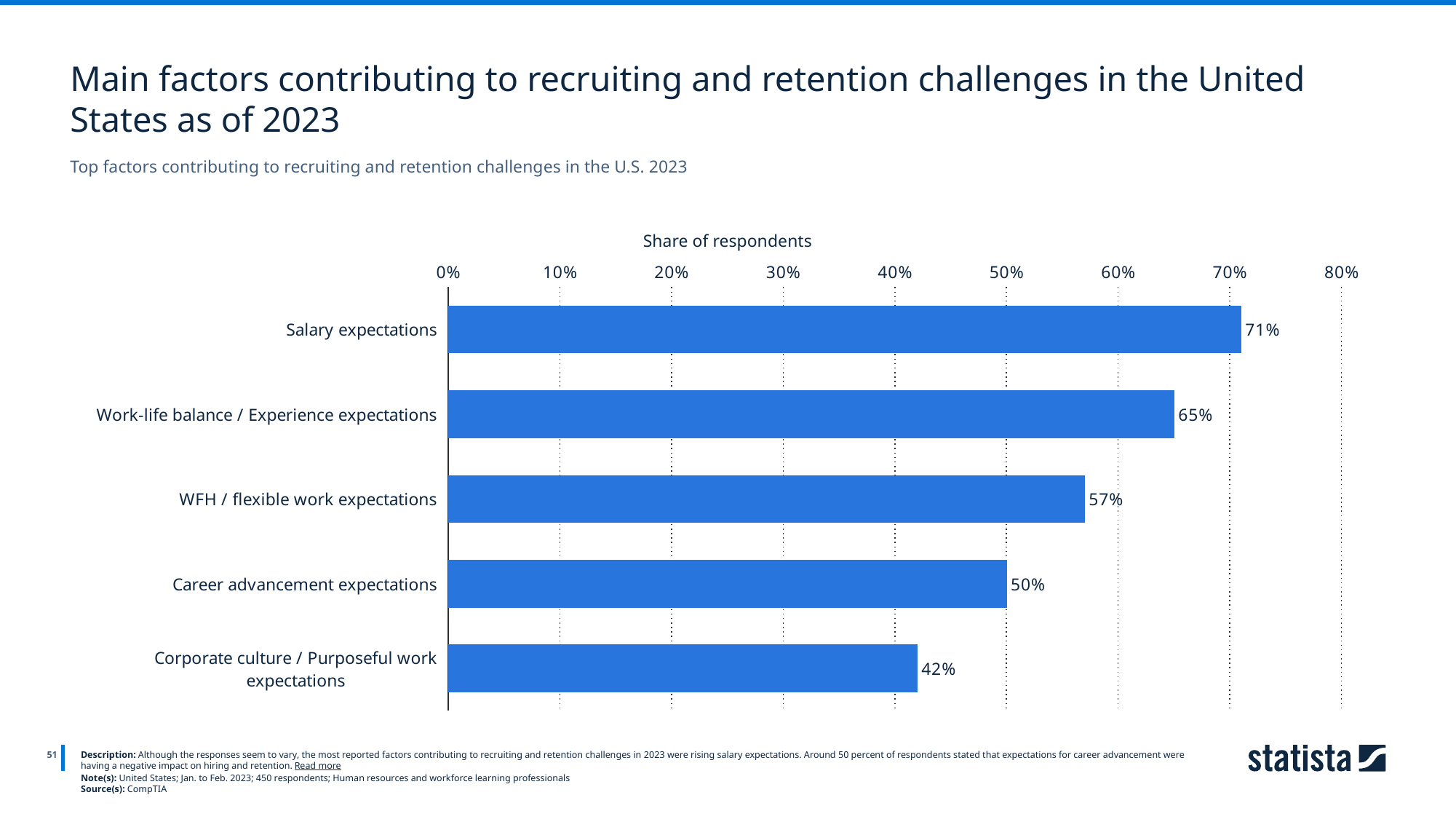
Which factor has the highest share of respondents? Salary expectations What share of respondents cited salary expectations as a factor? 71% Which has a larger share: work-life balance / experience expectations or career advancement expectations? Work-life balance / Experience expectations What is the difference between the shares for work-life balance / experience expectations and WFH / flexible work expectations? 8% How many factors are shown in the chart? 5 What is the difference between the shares for salary expectations and career advancement expectations? 21% What share of respondents cited corporate culture / purposeful work expectations? 42% What is the label of the value axis? Share of respondents What kind of chart is shown on the slide? Bar chart Which factor has the lowest share of respondents? Corporate culture / Purposeful work expectations Is the value for career advancement expectations greater or less than 60%? less What is the value for WFH / flexible work expectations? 57%